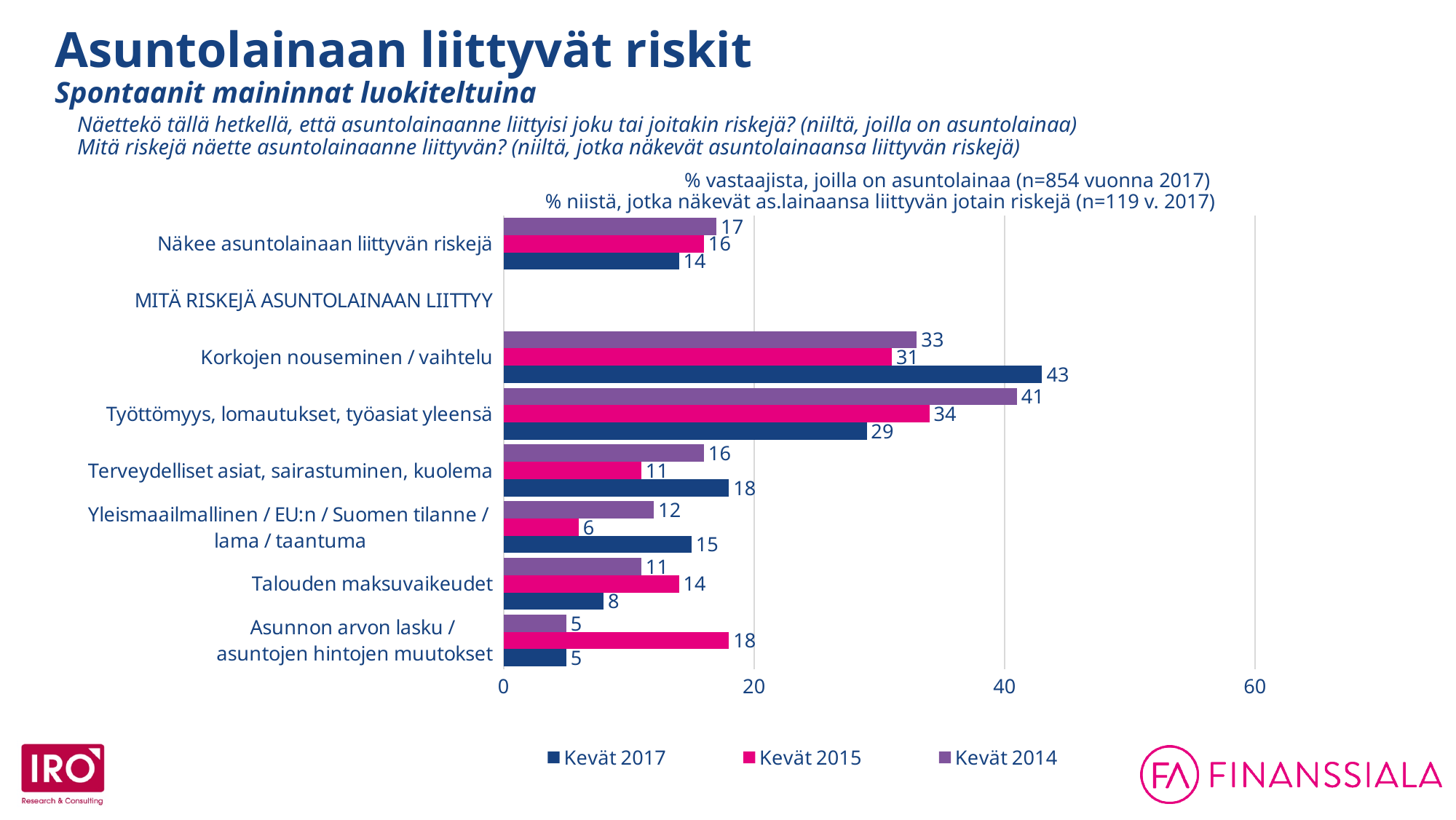
Which risk category has the lowest Kevät 2015 value? Yleismaailmallinen / EU:n / Suomen tilanne / lama / taantuma What is the value for Kevät 2017 for "Korkojen nouseminen / vaihtelu"? 43 What is the value for Kevät 2017 for "Näkee asuntolainaan liittyvän riskejä"? 14 For "Talouden maksuvaikeudet", which is larger: the Kevät 2015 value or the Kevät 2017 value? Kevät 2015 Which risk category has the highest Kevät 2017 value? Korkojen nouseminen / vaihtelu What is the difference between the Kevät 2017 and Kevät 2015 values for "Korkojen nouseminen / vaihtelu"? 12 Which colour represents Kevät 2015 in the chart? Pink Is the Kevät 2014 value for "Työttömyys, lomautukset, työasiat yleensä" greater or less than 40? greater What is the value for Kevät 2015 for "Asunnon arvon lasku / asuntojen hintojen muutokset"? 18 How many series does the legend list? 3 What is the value for Kevät 2014 for "Työttömyys, lomautukset, työasiat yleensä"? 41 What kind of chart is shown on the slide? Bar chart